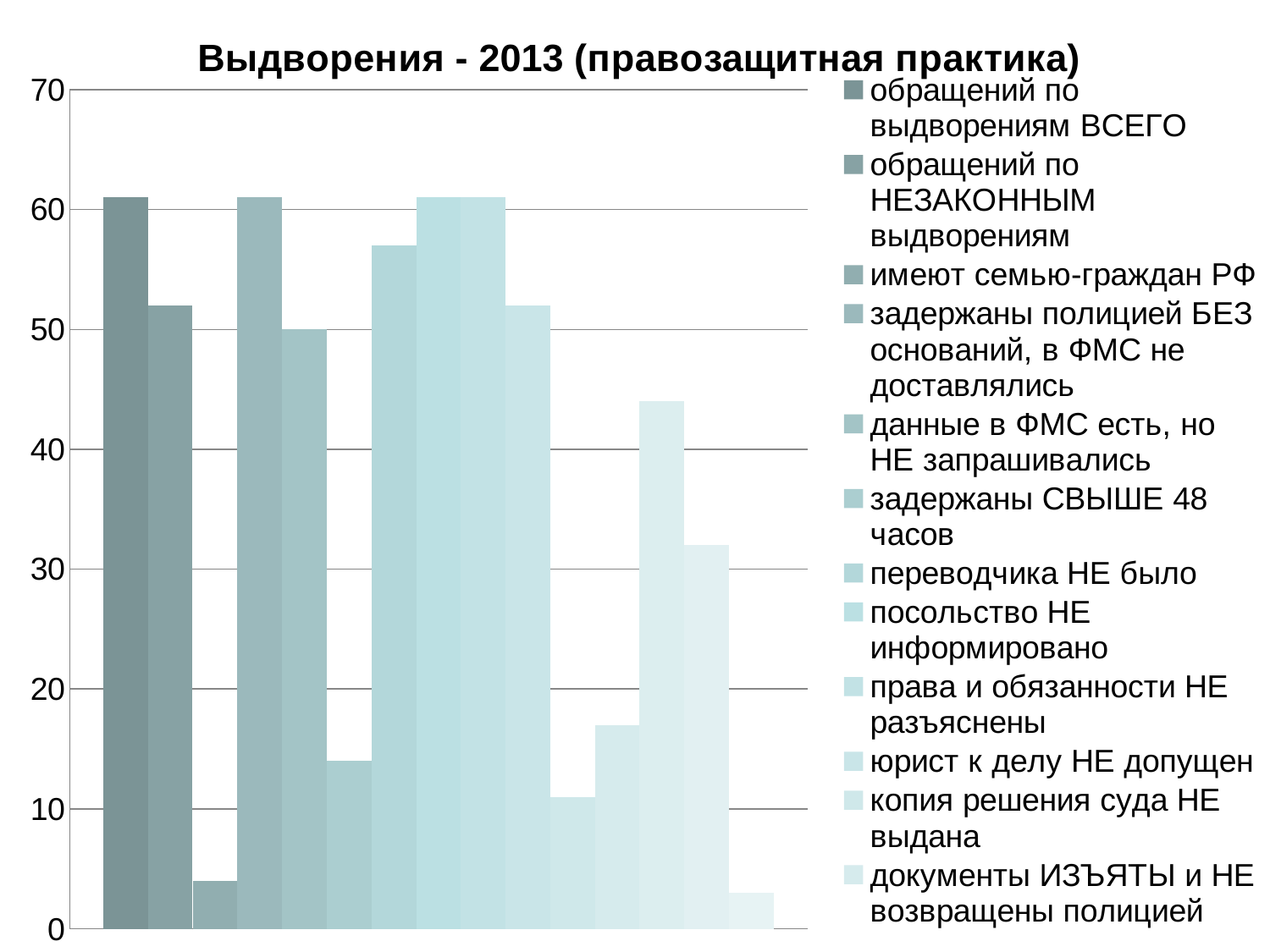
Is the value for "обращений по НЕЗАКОННЫМ выдворениям" greater or less than 50? greater What is the value for "данные в ФМС есть, но НЕ запрашивались"? 50 Which is larger: the value for "задержаны полицией БЕЗ оснований, в ФМС не доставлялись" or the value for "юрист к делу НЕ допущен"? задержаны полицией БЕЗ оснований, в ФМС не доставлялись Is the value for "обращений по выдворениям ВСЕГО" greater or less than 60? greater Is the value for "задержаны СВЫШЕ 48 часов" greater or less than 20? less Which is larger: the value for "обращений по выдворениям ВСЕГО" or the value for "обращений по НЕЗАКОННЫМ выдворениям"? обращений по выдворениям ВСЕГО Which is larger: the value for "имеют семью-граждан РФ" or the value for "задержаны СВЫШЕ 48 часов"? задержаны СВЫШЕ 48 часов What kind of chart is shown on the slide? bar chart What is the title of the chart? Выдворения - 2013 (правозащитная практика)